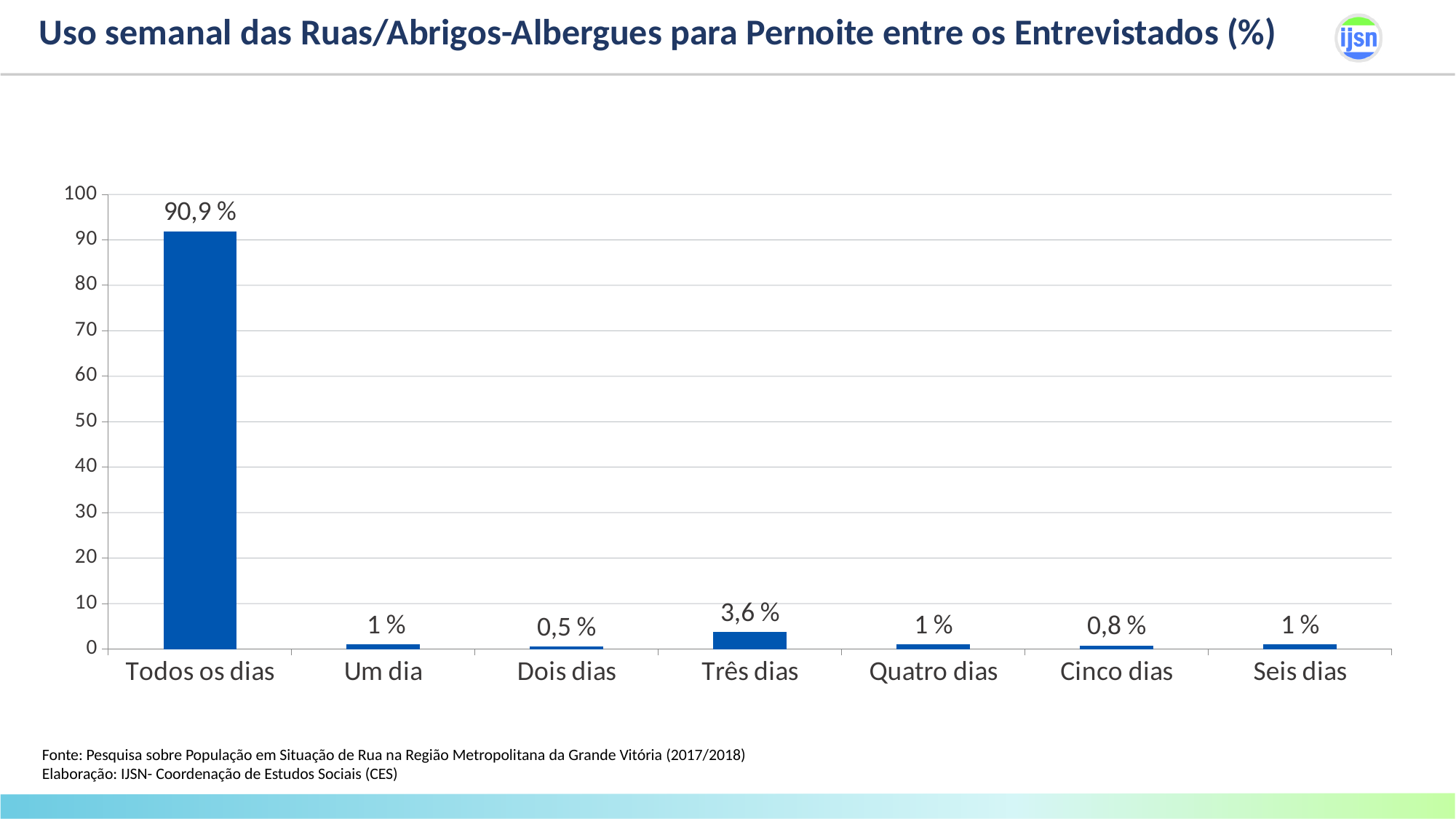
Which category has the highest value? Todos os dias Which is larger, the value for "Três dias" or the value for "Cinco dias"? Três dias What is the value for "Três dias"? 3,6 % What is the title of the chart? Uso semanal das Ruas/Abrigos-Albergues para Pernoite entre os Entrevistados (%) How many categories are shown on the x axis? 7 What is the value for "Todos os dias"? 90,9 % What is the value for "Dois dias"? 0,5 % What is the difference between the values for "Todos os dias" and "Três dias"? 87,3 % What is the value for "Cinco dias"? 0,8 % Which category has the lowest value? Dois dias Is the value for "Todos os dias" greater or less than 90? greater What kind of chart is shown on the slide? Bar chart